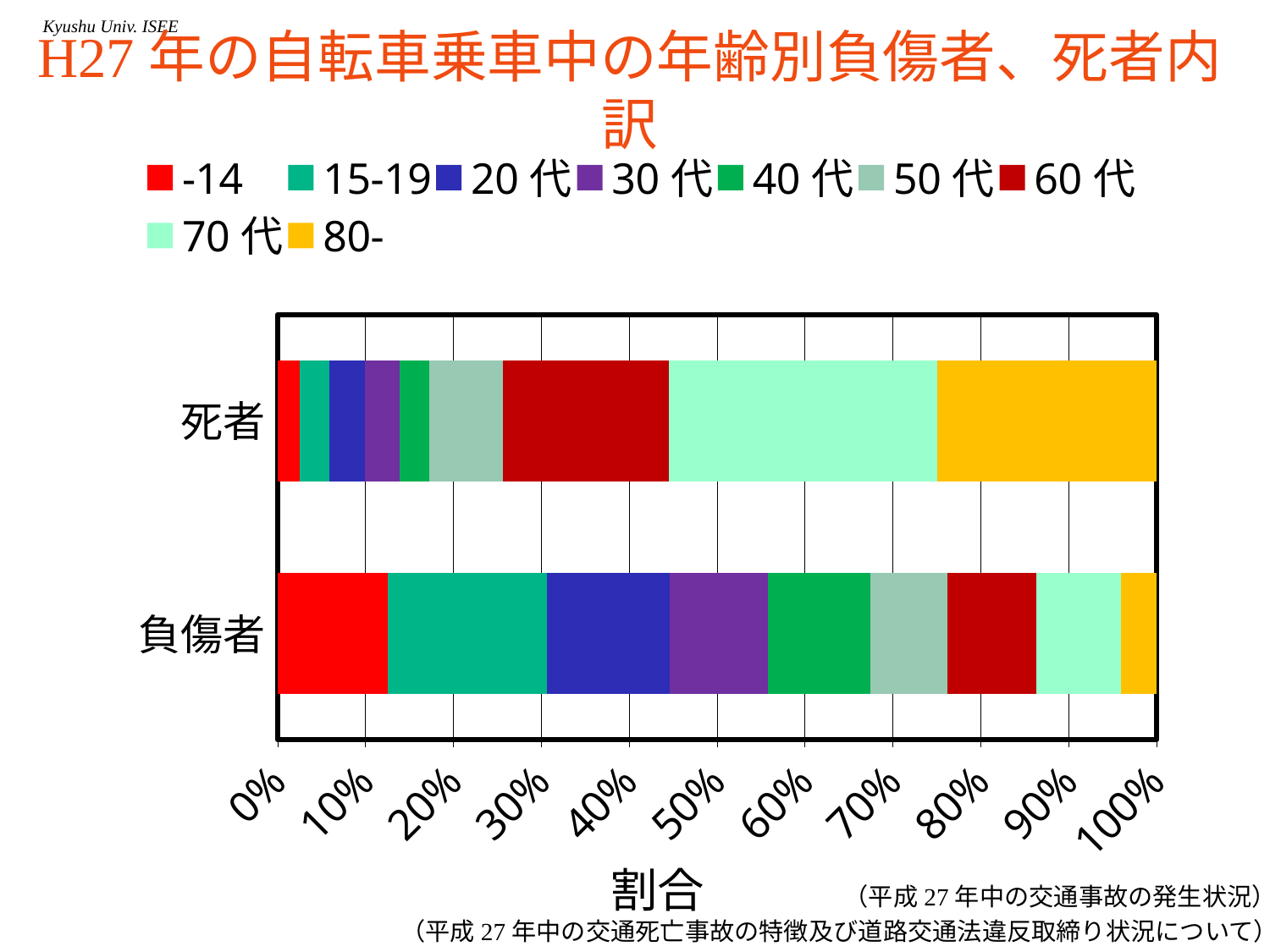
Which bar has the larger share for the -14 age group, 死者 or 負傷者? 負傷者 Which age group has the smallest share in the 負傷者 bar? 80- Which age group has the largest share in the 死者 bar? 70代 Is the share of 80- in the 負傷者 bar greater or less than 10%? less How many series does the legend list? 9 What is the label of the x axis? 割合 Which age group has the largest share in the 負傷者 bar? 15-19 Is the share of 70代 in the 死者 bar greater or less than 20%? greater How many bars (categories) does the chart show? 2 Is the share of -14 in the 負傷者 bar greater or less than 10%? greater Which bar has the larger share for the 80- age group, 死者 or 負傷者? 死者 What kind of chart is shown on the slide? stacked bar chart